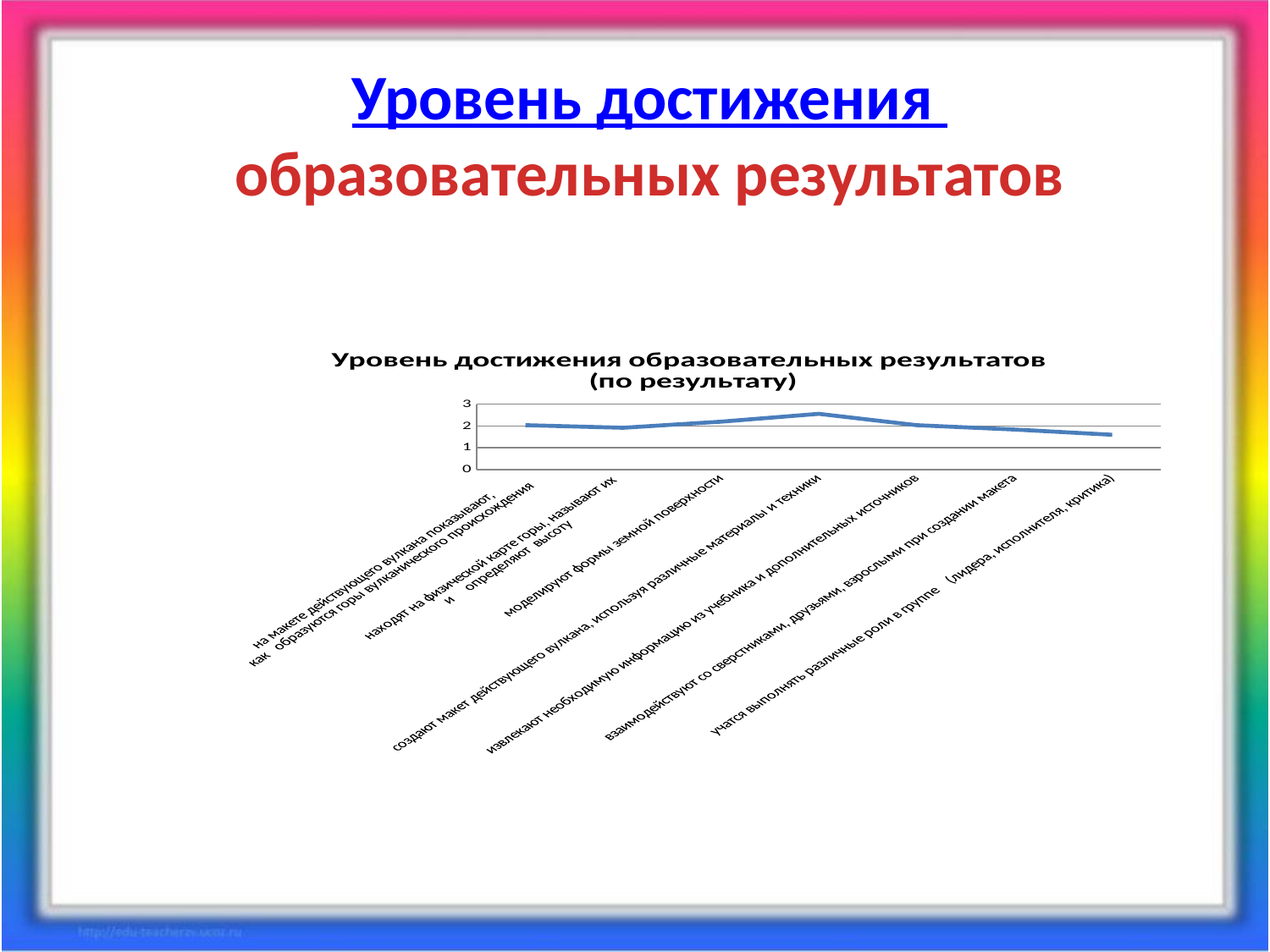
Is the value for 'создают макет действующего вулкана, используя различные материалы и техники' greater or less than 2? greater Is the value for 'взаимодействуют со сверстниками, друзьями, взрослыми при создании макета' greater or less than 2? less Which category has the highest value on the chart? создают макет действующего вулкана, используя различные материалы и техники Do the values rise or fall along the x axis from 'создают макет действующего вулкана, используя различные материалы и техники' to the last category? fall What is the highest value shown on the chart's y axis? 3 Which category has the lowest value on the chart? учатся выполнять различные роли в группе (лидера, исполнителя, критика) Which is larger: the value for 'создают макет действующего вулкана, используя различные материалы и техники' or the value for 'учатся выполнять различные роли в группе (лидера, исполнителя, критика)'? создают макет действующего вулкана, используя различные материалы и техники What is the title of the chart? Уровень достижения образовательных результатов (по результату) Is the value for 'учатся выполнять различные роли в группе (лидера, исполнителя, критика)' greater or less than 2? less What kind of chart is shown on the slide? line chart How many categories are plotted along the x axis of the chart? 7